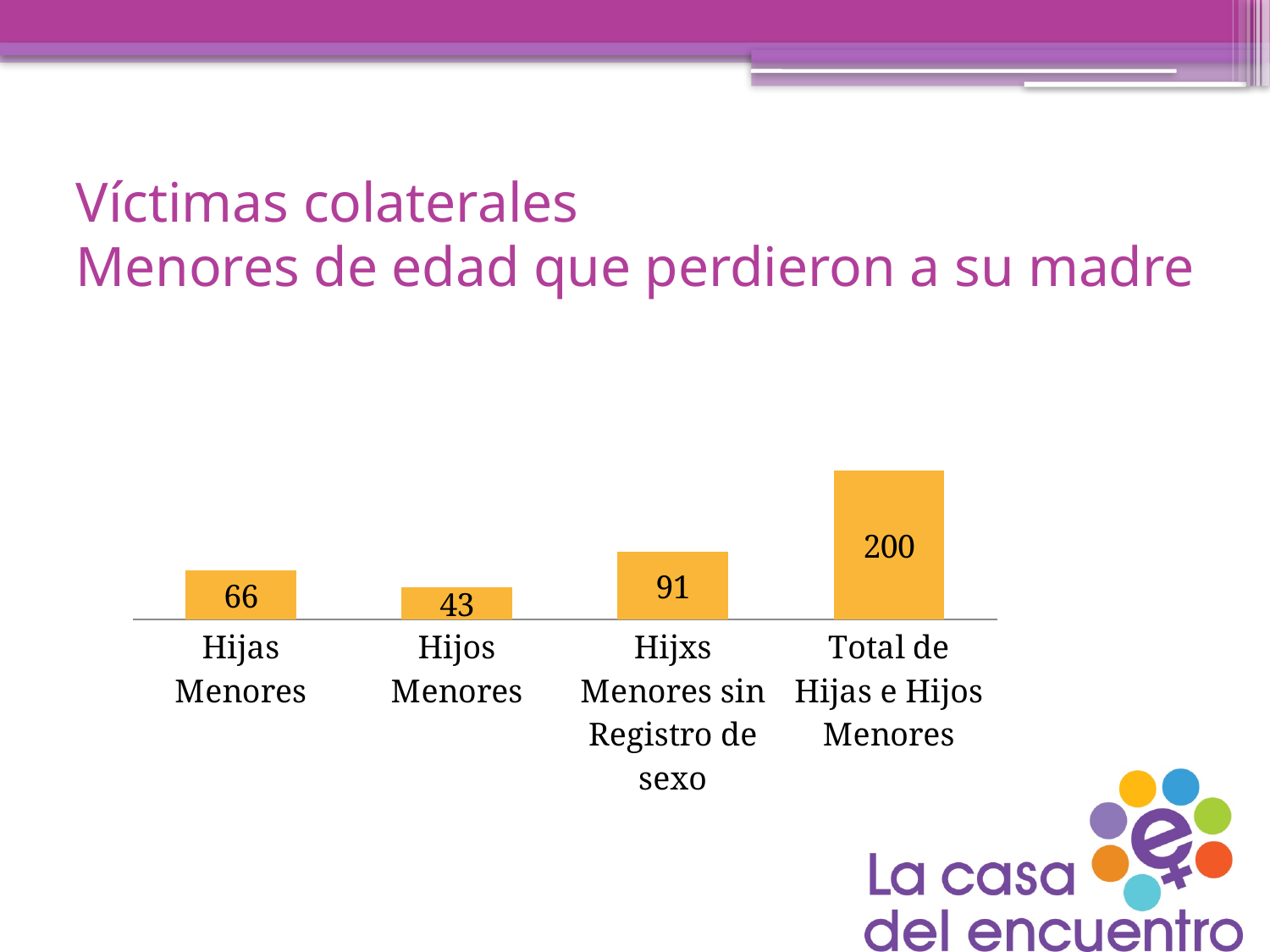
What is the difference between the values for Hijxs Menores sin Registro de sexo and Hijas Menores? 25 Which is larger, the value for Hijas Menores or the value for Hijxs Menores sin Registro de sexo? Hijxs Menores sin Registro de sexo What colour are the bars in the chart? Orange Which category has the lowest value? Hijos Menores What is the value for Total de Hijas e Hijos Menores? 200 What is the value for Hijas Menores? 66 What is the value for Hijxs Menores sin Registro de sexo? 91 How many categories are shown in the chart? 4 What is the value for Hijos Menores? 43 Which category has the highest value? Total de Hijas e Hijos Menores What is the difference between the values for Hijas Menores and Hijos Menores? 23 What kind of chart is shown on the slide? Bar chart